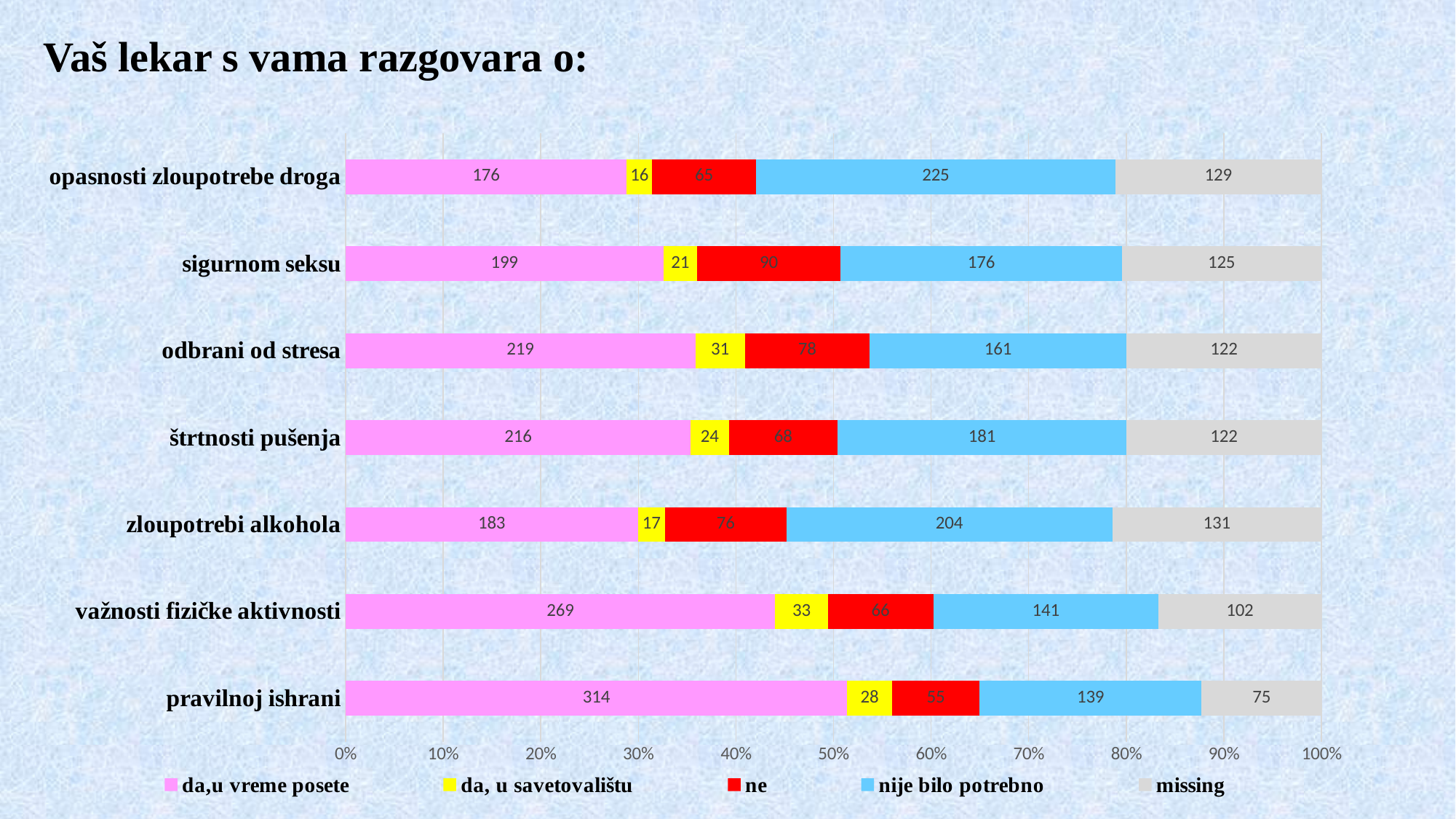
What kind of chart is shown on the slide? stacked bar chart What is the difference between the "nije bilo potrebno" values for "opasnosti zloupotrebe droga" and "pravilnoj ishrani"? 86 How many categories are shown on the chart? 7 Which category has the lowest "missing" value? pravilnoj ishrani Which has a larger "ne" value: "sigurnom seksu" or "odbrani od stresa"? sigurnom seksu What is the value of "ne" for "sigurnom seksu"? 90 Which category has the highest value for "da,u vreme posete"? pravilnoj ishrani How many series does the legend list? 5 What is the value of "da,u vreme posete" for "pravilnoj ishrani"? 314 What is the total of all segments in the "pravilnoj ishrani" bar? 611 What is the "missing" value for "zloupotrebi alkohola"? 131 Which category has the highest value for "nije bilo potrebno"? opasnosti zloupotrebe droga